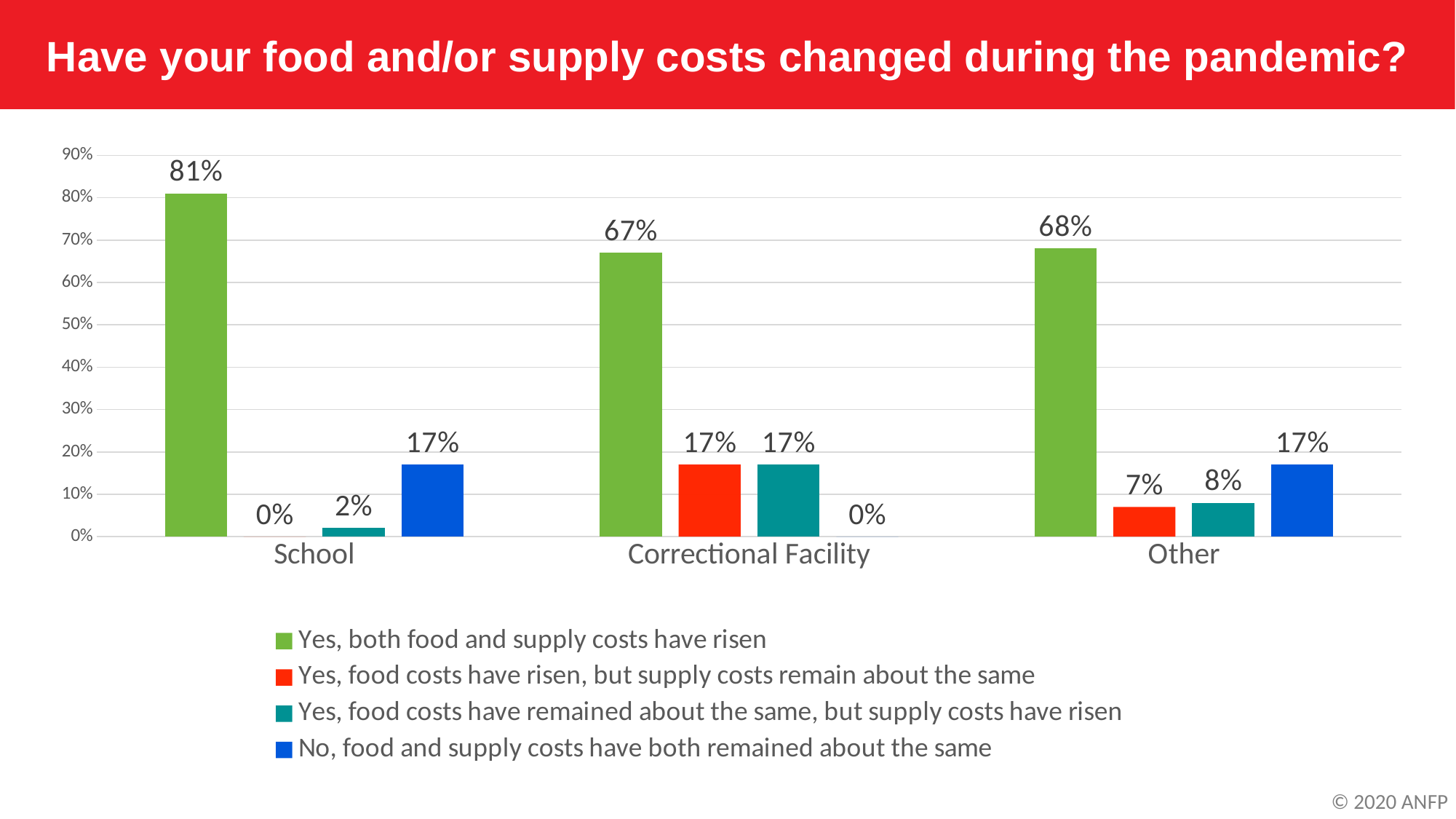
What percentage of Correctional Facility respondents said food and supply costs have both remained about the same? 0% What percentage of School respondents said both food and supply costs have risen? 81% Which category has the highest value for 'Yes, both food and supply costs have risen'? School How many series does the legend list? 4 What colour represents 'No, food and supply costs have both remained about the same'? Blue What is the difference between the School and Other values for 'Yes, both food and supply costs have risen'? 13% What percentage of Other respondents said food costs have remained about the same but supply costs have risen? 8% What percentage of Correctional Facility respondents said food costs have risen but supply costs remain about the same? 17% Which is larger: the 'Yes, food costs have risen, but supply costs remain about the same' value for Correctional Facility or for Other? Correctional Facility How many categories are shown on the x axis? 3 What kind of chart is shown on the slide? Bar chart Which category has the lowest value for 'Yes, both food and supply costs have risen'? Correctional Facility